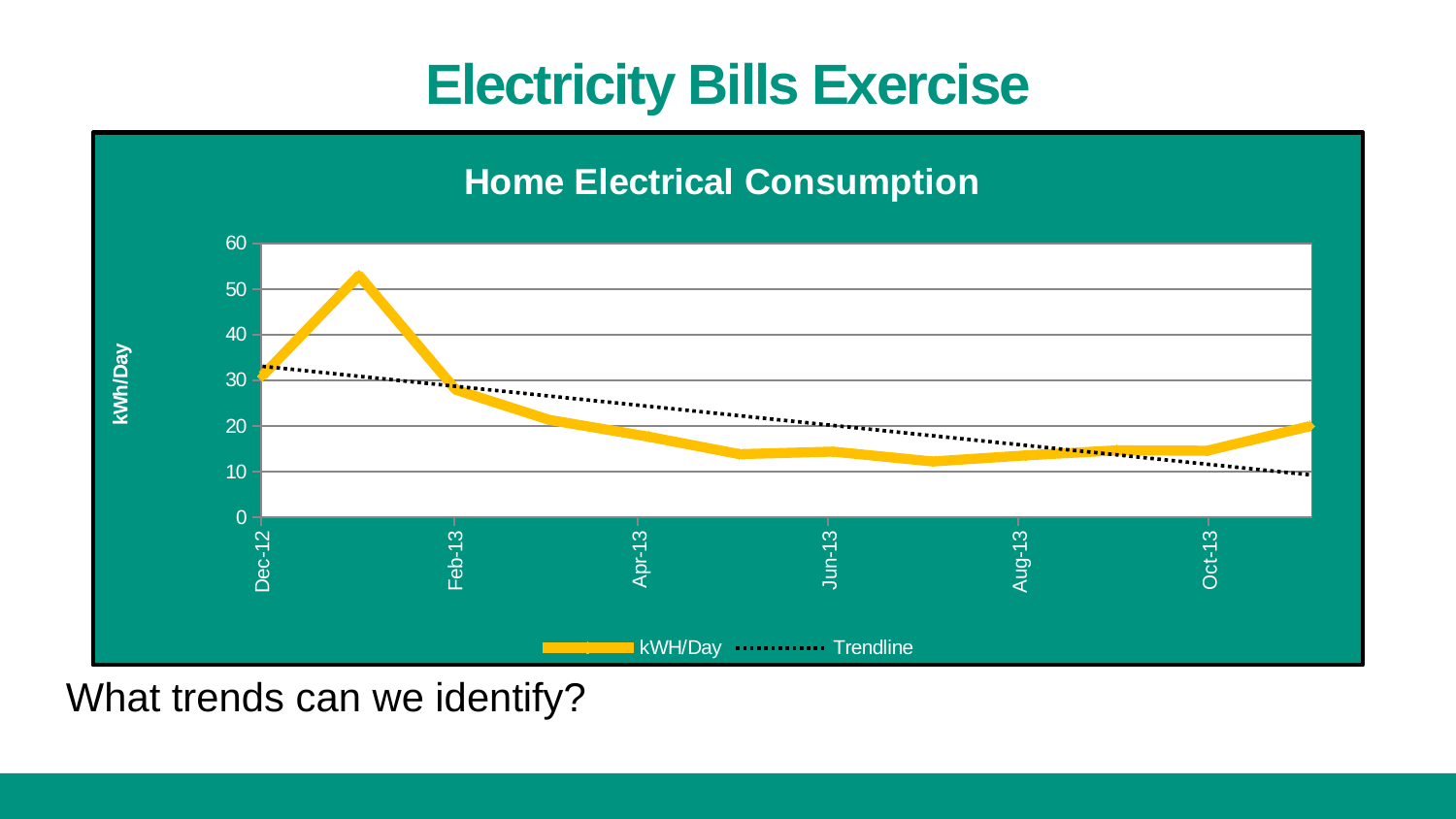
Is the value for Aug-13 greater or less than 20? less Is the highest point on the kWH/Day line greater or less than 50? greater Is the value for Jun-13 greater or less than 20? less What kind of chart is shown on the slide? line chart Which has the larger value, Feb-13 or Aug-13? Feb-13 Which has the larger value, Dec-12 or Jun-13? Dec-12 What is the title of the chart? Home Electrical Consumption What is the label on the vertical axis? kWh/Day Does the trendline rise or fall from left to right? fall How many series does the legend list? 2